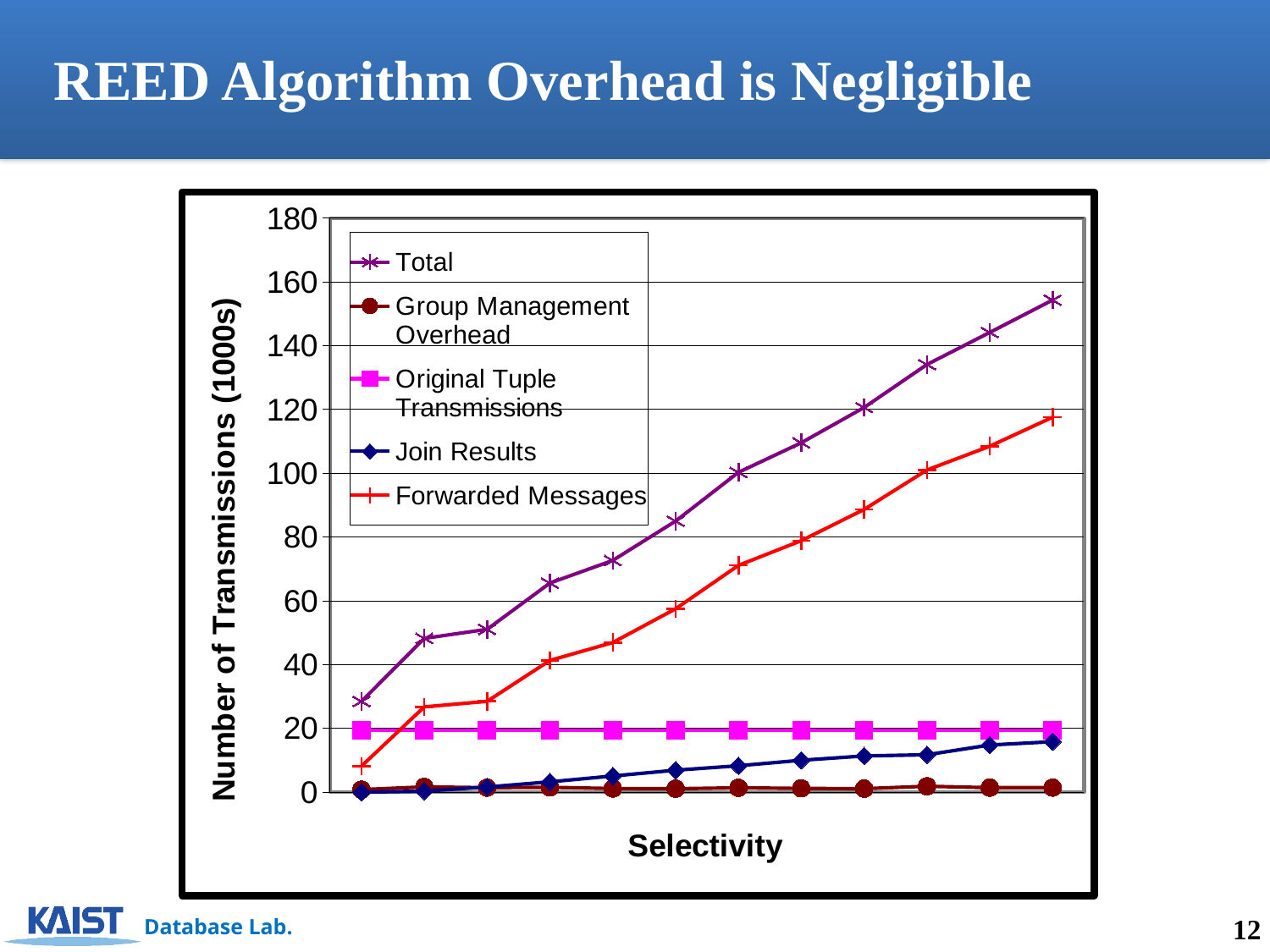
How many series does the legend list? 5 How many data points are plotted for the Total series? 12 Which series reaches the highest value on the chart? Total Does the Total series rise or fall as selectivity increases along the x axis? rises Is the value of the Forwarded Messages series at the rightmost point greater or less than 100? greater Is the value of the Total series at the leftmost point greater or less than 40? less Does the Original Tuple Transmissions series rise, fall, or stay flat along the x axis? stays flat Is the highest value of the Join Results series greater or less than 20? less What is the title of the vertical axis? Number of Transmissions (1000s) What is the title of the horizontal axis? Selectivity What kind of chart is shown on the slide? line chart